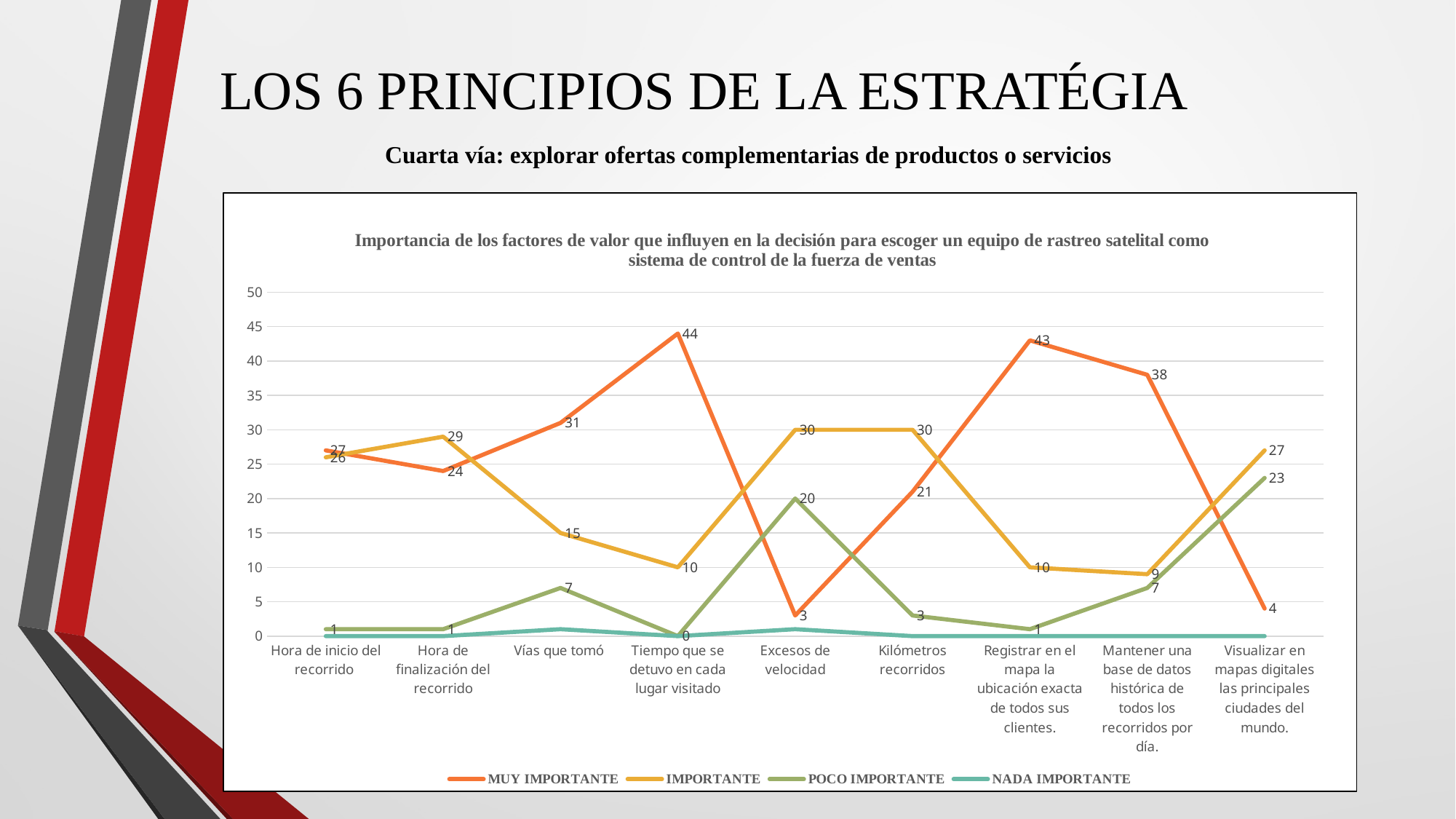
What is the POCO IMPORTANTE value for 'Visualizar en mapas digitales las principales ciudades del mundo.'? 23 How many categories are shown along the x axis? 9 What is the IMPORTANTE value for 'Vías que tomó'? 15 What is the MUY IMPORTANTE value for 'Tiempo que se detuvo en cada lugar visitado'? 44 Which category has the highest MUY IMPORTANTE value? Tiempo que se detuvo en cada lugar visitado What colour is the MUY IMPORTANTE line? orange What is the difference between the MUY IMPORTANTE values for 'Registrar en el mapa la ubicación exacta de todos sus clientes.' and 'Mantener una base de datos histórica de todos los recorridos por día.'? 5 How many series does the legend list? 4 Which category has the lowest MUY IMPORTANTE value? Excesos de velocidad What kind of chart is shown on the slide? line chart Does the MUY IMPORTANTE line rise or fall from 'Registrar en el mapa la ubicación exacta de todos sus clientes.' to 'Visualizar en mapas digitales las principales ciudades del mundo.'? fall For 'Excesos de velocidad', which is larger: the IMPORTANTE value or the POCO IMPORTANTE value? IMPORTANTE